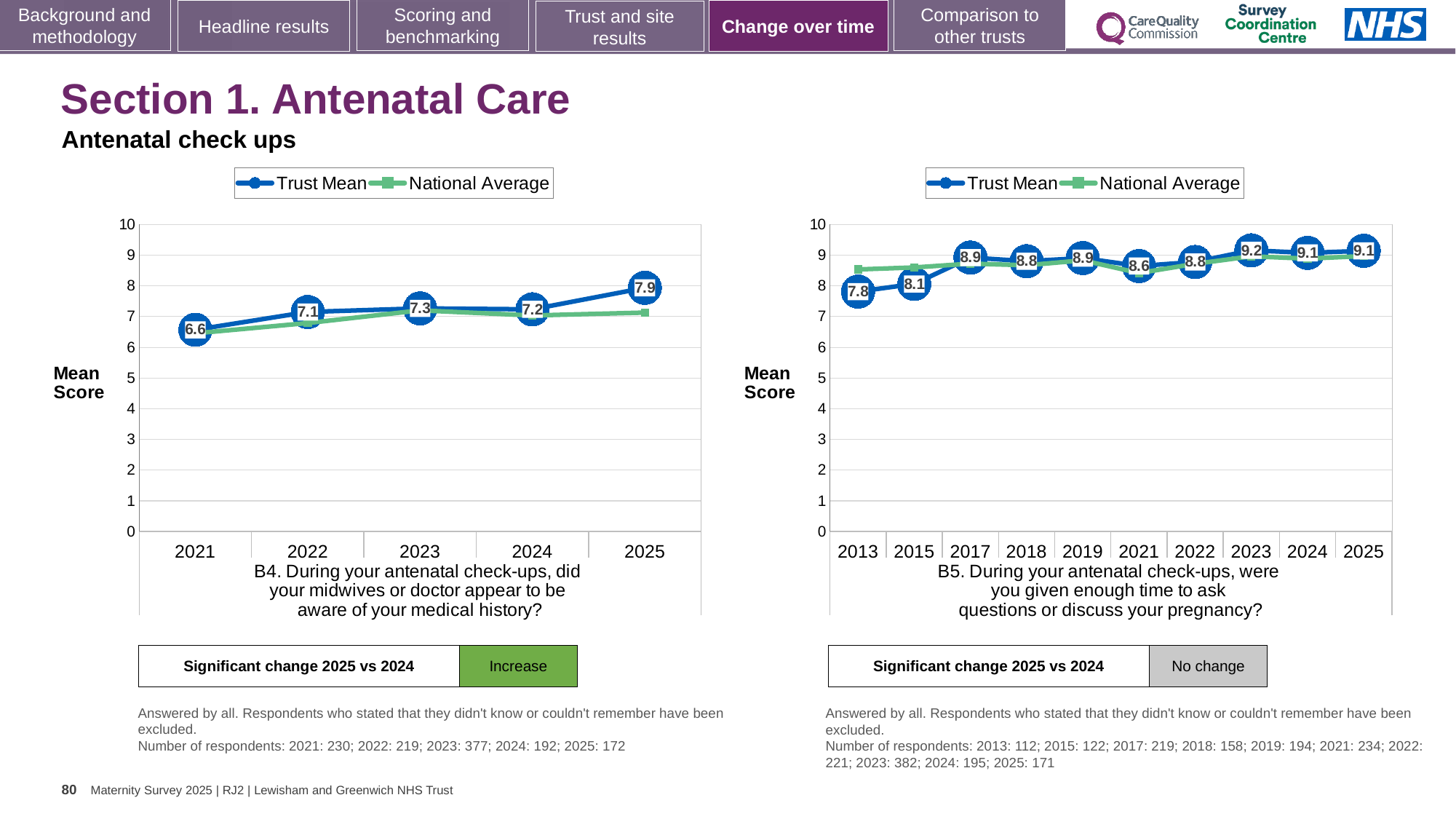
In the left chart (B4), what is the Trust Mean score for 2021? 6.6 In the right chart (B5), what is the Trust Mean score for 2021? 8.6 In the left chart (B4), which year has the highest Trust Mean score? 2025 In the right chart (B5), how many years are plotted on the x axis? 10 In the left chart (B4), what is the Trust Mean score for 2025? 7.9 In the right chart (B5), which is larger, the Trust Mean score for 2023 or for 2021? 2023 In the right chart (B5), what is the Trust Mean score for 2013? 7.8 In the right chart (B5), which year has the lowest Trust Mean score? 2013 In the left chart (B4), is the National Average value for 2025 greater or less than 8? less In the left chart (B4), how many years are plotted on the x axis? 5 In the left chart (B4), what is the difference between the Trust Mean scores for 2025 and 2024? 0.7 How many series does the legend of the right chart (B5) list? 2